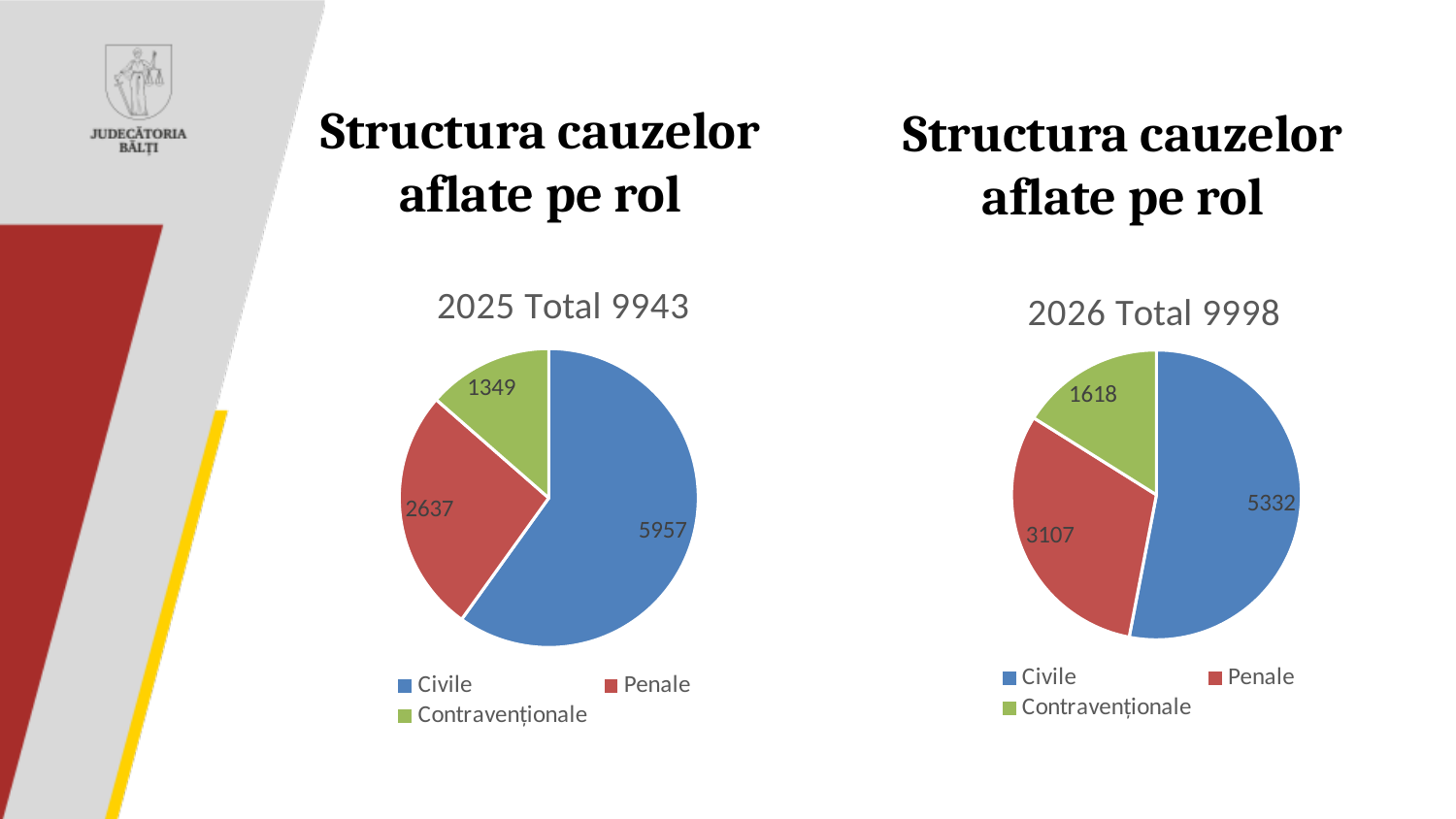
In the 2025 Total 9943 chart, what is the difference between Civile and Penale? 3320 In the 2025 Total 9943 chart, what share of the total is Contravenționale? 13.6% Which is larger: Contravenționale in the 2025 Total 9943 chart or Contravenționale in the 2026 Total 9998 chart? 2026 Total 9998 chart (1618) In the 2026 Total 9998 chart, what colour is the Penale slice? Red In the 2026 Total 9998 chart, which category has the largest slice? Civile In the 2026 Total 9998 chart, what is the difference between Civile and Penale? 2225 How many categories does the 2026 Total 9998 chart show? 3 In the 2025 Total 9943 chart, what is the value for Contravenționale? 1349 In the 2025 Total 9943 chart, which category has the smallest slice? Contravenționale In the 2025 Total 9943 chart, what is the value for Civile? 5957 What kind of chart is the 2025 Total 9943 chart? Pie chart In the 2026 Total 9998 chart, what is the value for Penale? 3107